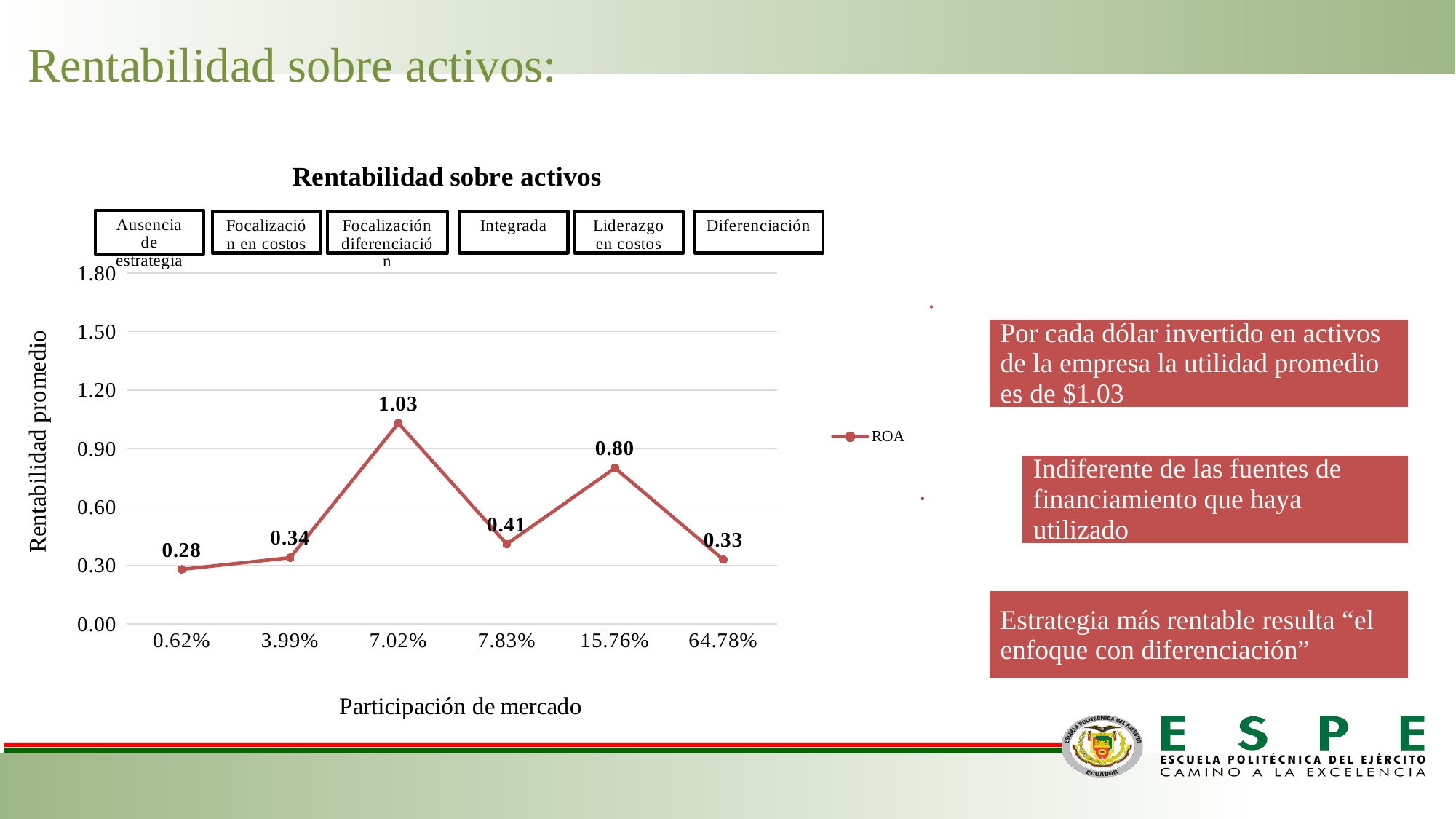
How many data points are plotted on the ROA line? 6 What is the ROA value at the 64.78% market share point? 0.33 What is the ROA value at the 15.76% market share point? 0.80 What is the ROA value at the 7.02% market share point? 1.03 How many series does the legend list? 1 At which market share value is the ROA lowest? 0.62% What is the ROA value at the 0.62% market share point? 0.28 Which has a higher ROA: the 7.83% point or the 3.99% point? 7.83% What is the difference between the ROA at 7.02% and the ROA at 15.76%? 0.23 What type of chart is shown? Line chart What is the title of the chart? Rentabilidad sobre activos At which market share value is the ROA highest? 7.02%